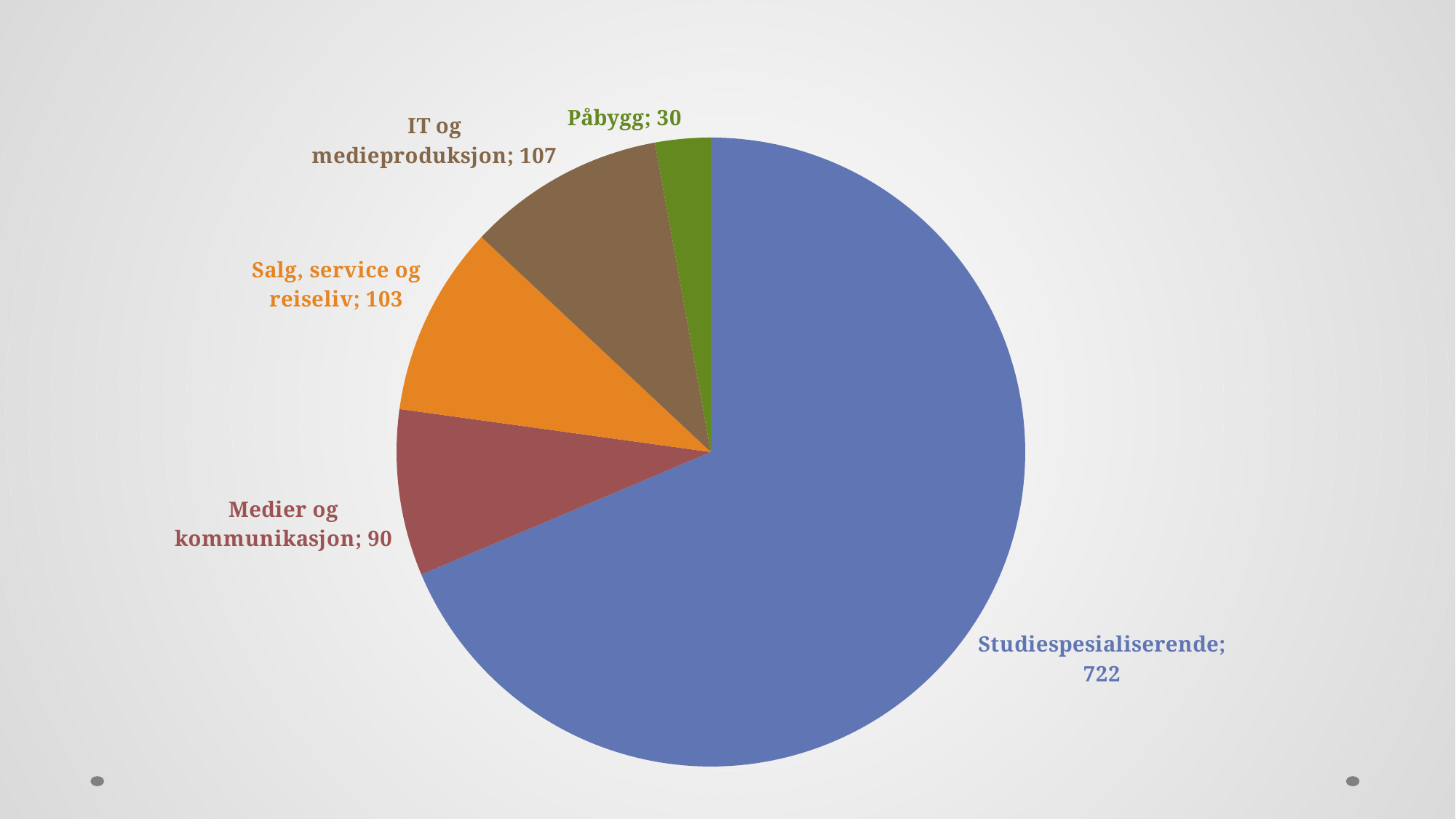
Which category has the largest slice? Studiespesialiserende What is the total of all slices in the pie chart? 1052 What is the value for IT og medieproduksjon? 107 What is the value for Salg, service og reiseliv? 103 Which is larger, IT og medieproduksjon or Salg, service og reiseliv? IT og medieproduksjon What is the value for Studiespesialiserende? 722 How many slices does the pie chart have? 5 What type of chart is shown on the slide? Pie chart What is the difference between Studiespesialiserende and Medier og kommunikasjon? 632 Which category has the smallest slice? Påbygg What is the value for Påbygg? 30 What colour is the Studiespesialiserende slice? Blue